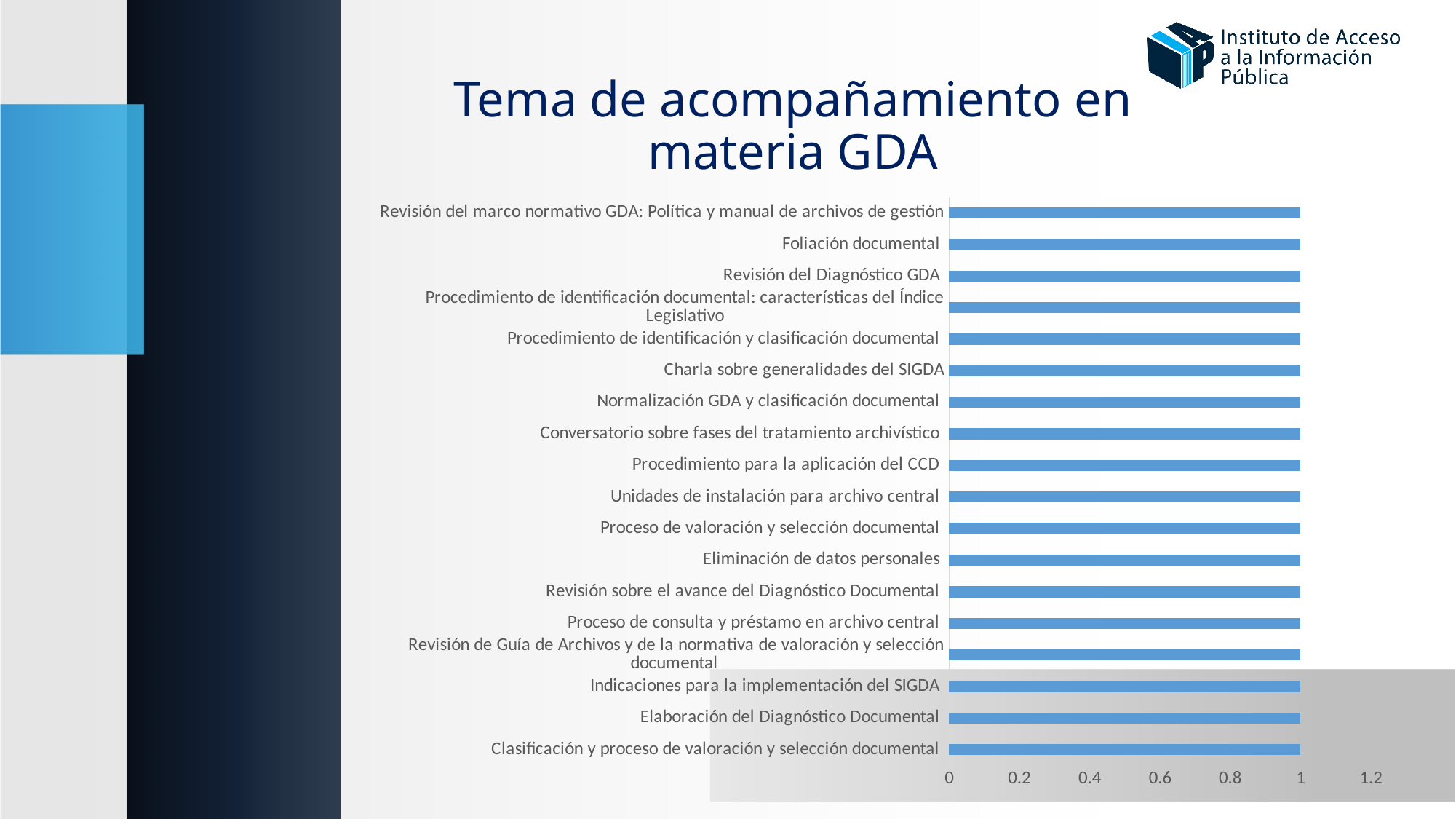
What is the value for "Elaboración del Diagnóstico Documental"? 1 Is the value for "Revisión del Diagnóstico GDA" greater or less than 1.2? less What is the title of the chart on the slide? Tema de acompañamiento en materia GDA What is the value for "Charla sobre generalidades del SIGDA"? 1 What is the value for "Foliación documental"? 1 What is the difference between the values for "Foliación documental" and "Unidades de instalación para archivo central"? 0 How many categories (topics) are plotted in the chart? 18 What is the value for "Eliminación de datos personales"? 1 Is the value for "Procedimiento para la aplicación del CCD" greater or less than 0.8? greater What is the highest value shown on the horizontal axis? 1.2 Which category is listed at the bottom of the chart? Clasificación y proceso de valoración y selección documental What kind of chart is shown on the slide? bar chart